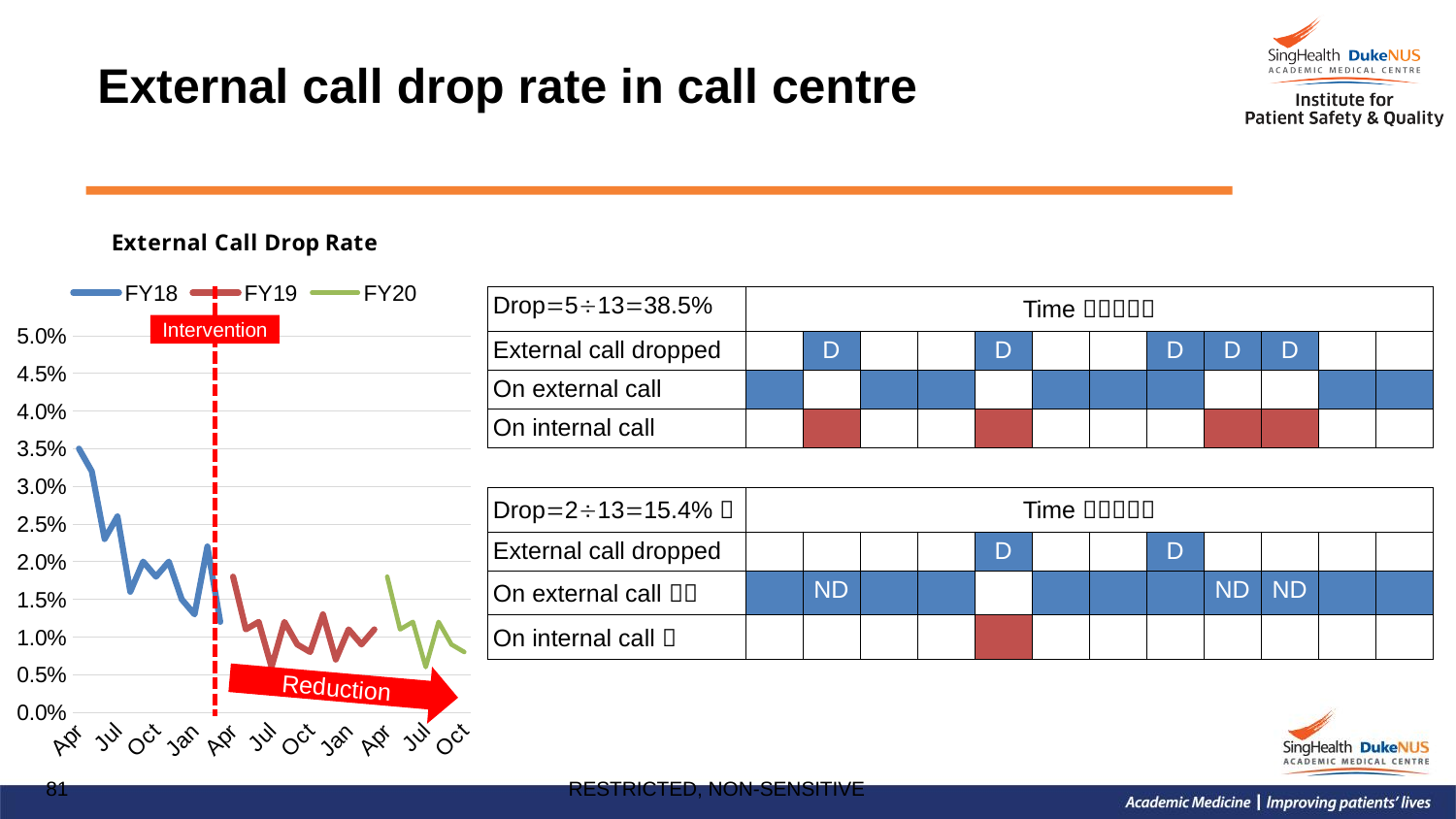
Which series in the External Call Drop Rate chart reaches the highest value? FY18 Are the FY19 values in the External Call Drop Rate chart greater or less than 2.5%? less What kind of chart is the External Call Drop Rate chart? Line chart How many series does the legend of the External Call Drop Rate chart list? 3 Which series are listed in the legend of the External Call Drop Rate chart? FY18, FY19, FY20 In the External Call Drop Rate chart, which is larger: the highest FY18 value or the highest FY20 value? The highest FY18 value Is the first FY18 value (Apr) in the External Call Drop Rate chart greater or less than 2.0%? greater What is the title of the line chart on the slide? External Call Drop Rate Does the FY18 line in the External Call Drop Rate chart generally rise or fall from Apr to the following Apr? Fall Are the FY20 values in the External Call Drop Rate chart greater or less than 2.0%? less What is the maximum value shown on the y axis of the External Call Drop Rate chart? 5.0%